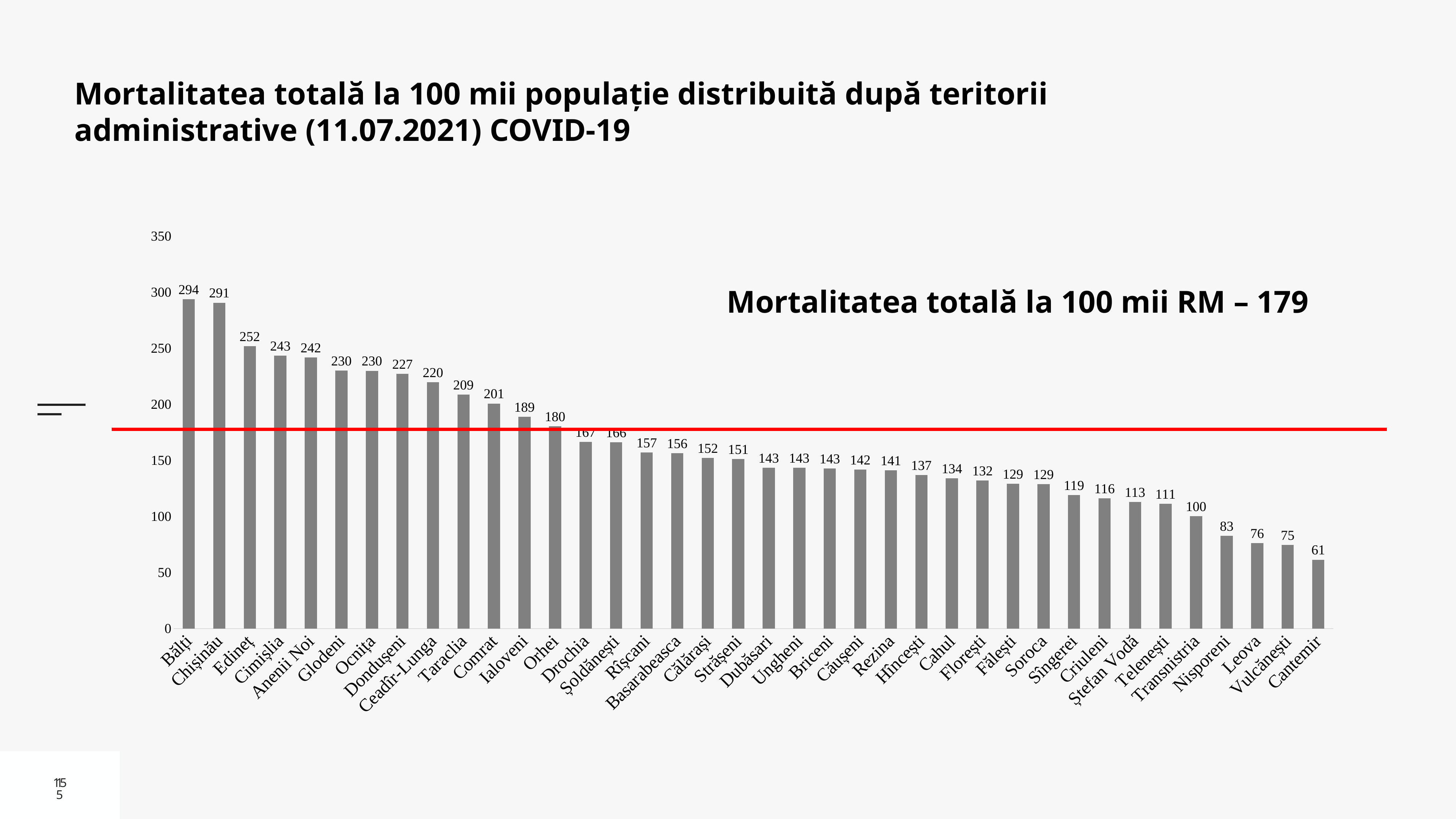
What is the value for Bălți? 294 Is the value for Soroca greater or less than 150? less What is the difference between the values for Chișinău and Edineț? 39 How many territories are shown on the x axis? 38 What value does the red horizontal line on the chart represent, according to the text on the slide? 179 Which territory has the highest value? Bălți Do the values rise or fall from left to right along the x axis? fall What is the value for Orhei? 180 Which is larger, the value for Taraclia or the value for Comrat? Taraclia What kind of chart is shown on the slide? bar chart Which territory has the lowest value? Cantemir What is the value for Transnistria? 100